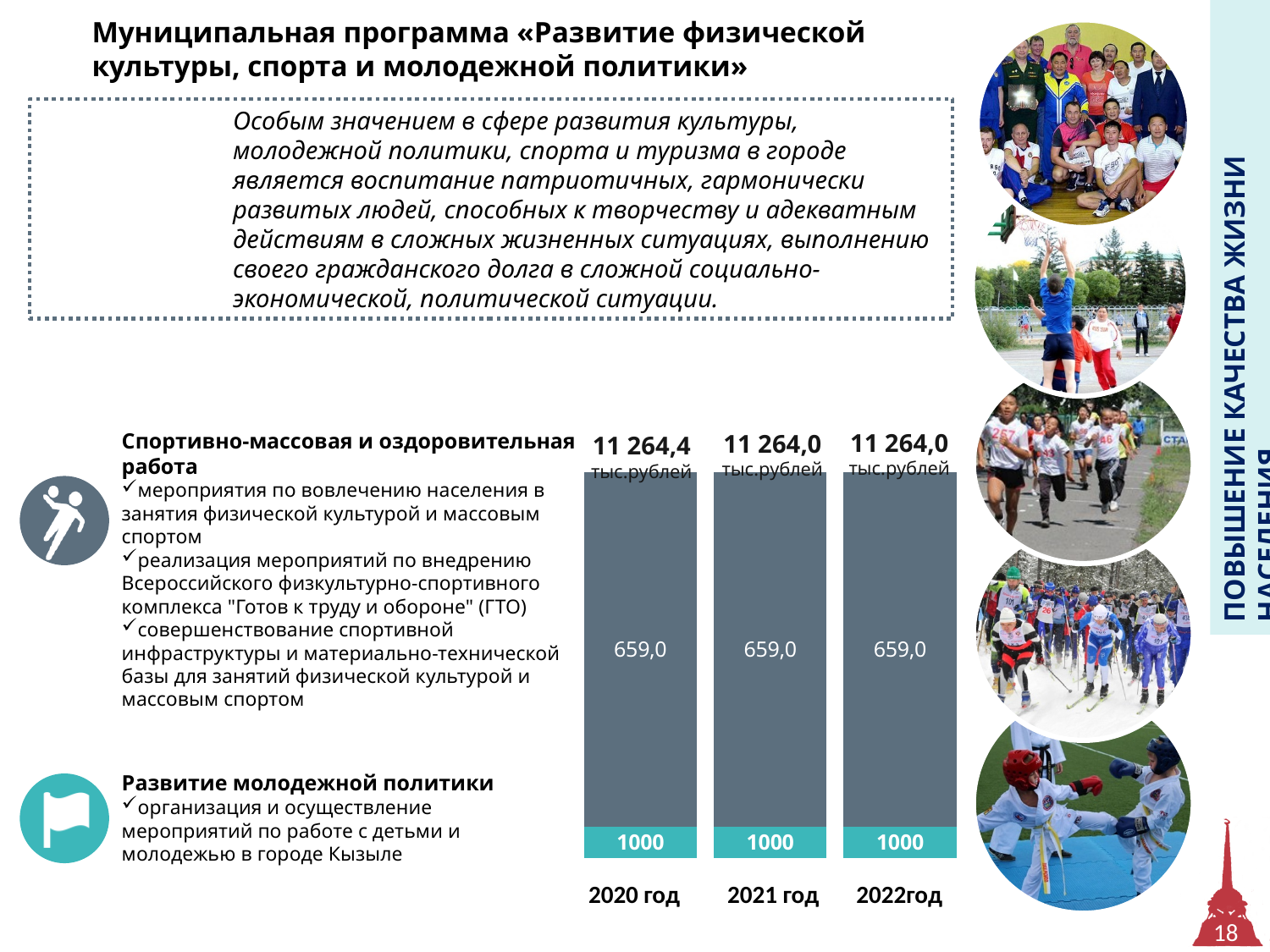
What total amount is printed above the bar for 2022год? 11 264,0 тыс.рублей Which year has the highest total printed above its bar? 2020 год What is the difference between the total printed for 2020 год and the total printed for 2021 год? 0,4 тыс.рублей What is the value of the dark (upper) segment of the bar for 2022год? 659,0 What is the value of the dark (upper) segment of the bar for 2021 год? 659,0 What is the value of the teal (bottom) segment of the bar for 2020 год? 1000 What total amount is printed above the bar for 2020 год? 11 264,4 тыс.рублей What are the category labels along the bottom of the chart? 2020 год, 2021 год, 2022год How many bars (years) does the chart show? 3 What total amount is printed above the bar for 2021 год? 11 264,0 тыс.рублей What kind of chart is shown on the slide? stacked bar chart